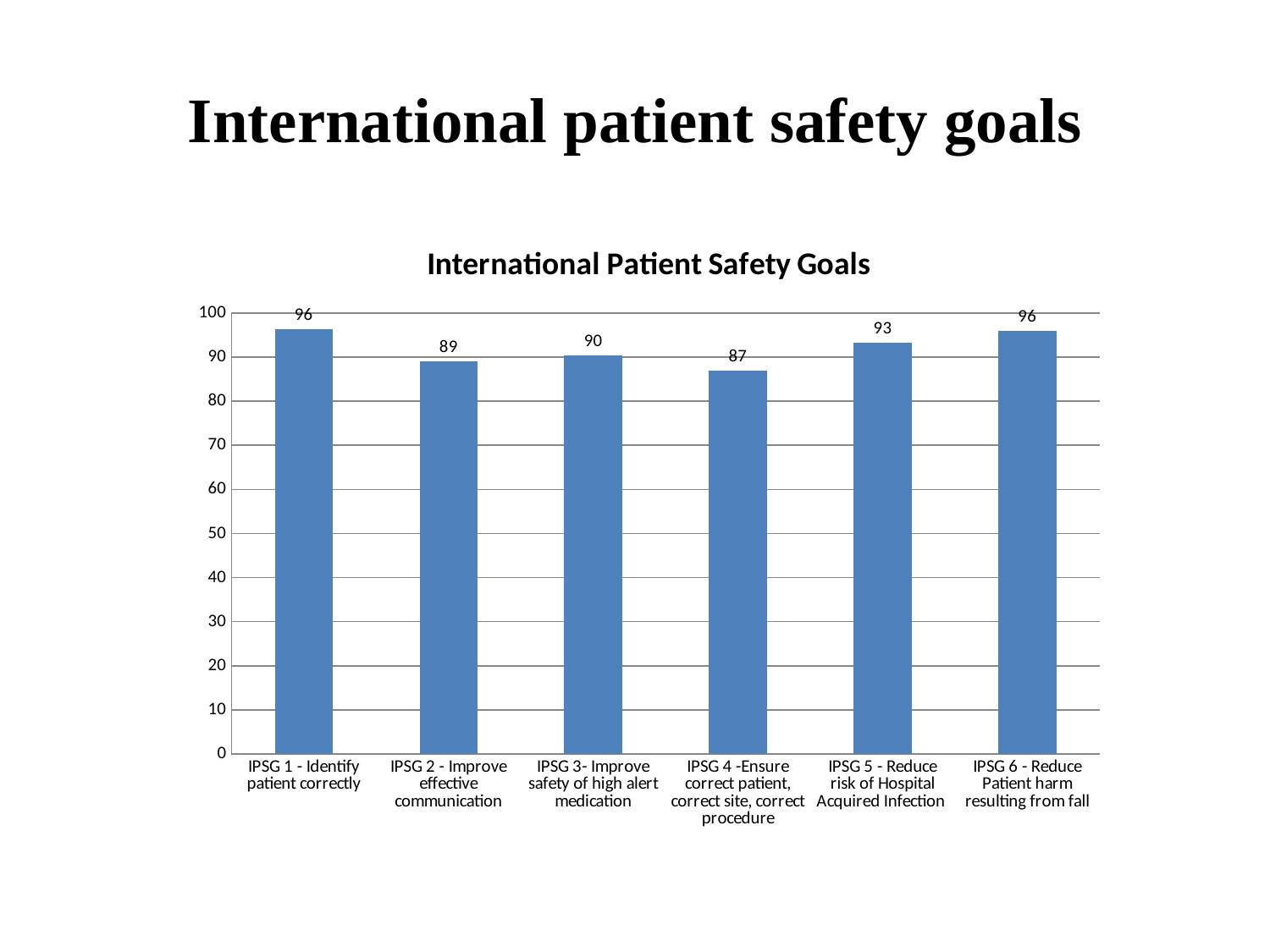
What is the value for IPSG 4 - Ensure correct patient, correct site, correct procedure? 87 What is the difference between the values for IPSG 5 and IPSG 4? 6 Which category has the lowest value? IPSG 4 - Ensure correct patient, correct site, correct procedure What is the value for IPSG 5 - Reduce risk of Hospital Acquired Infection? 93 What kind of chart is shown on the slide? Bar chart What is the title of the chart? International Patient Safety Goals Which is larger, the value for IPSG 3 - Improve safety of high alert medication or the value for IPSG 5 - Reduce risk of Hospital Acquired Infection? IPSG 5 - Reduce risk of Hospital Acquired Infection How many categories are shown on the chart? 6 What is the difference between the values for IPSG 1 and IPSG 2? 7 Is the value for IPSG 3 - Improve safety of high alert medication greater or less than 80? greater What is the value for IPSG 1 - Identify patient correctly? 96 What is the value for IPSG 2 - Improve effective communication? 89